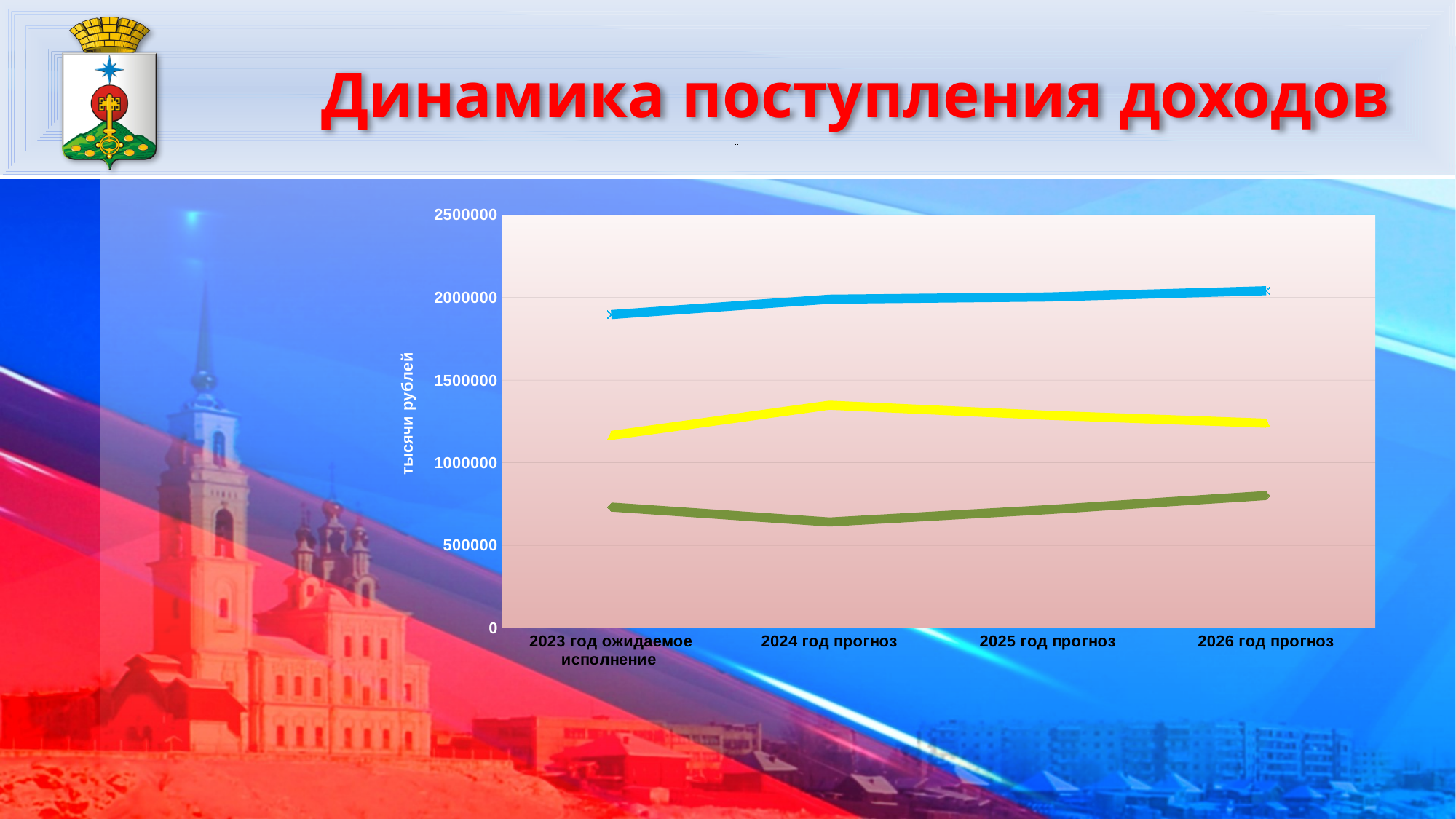
What is the title of the slide's chart? Динамика поступления доходов In which category does the yellow line reach its highest value? 2024 год прогноз Does the blue line rise or fall from 2023 год ожидаемое исполнение to 2026 год прогноз? rise Which is larger for 2023 год ожидаемое исполнение: the blue line or the yellow line? the blue line Is the value of the yellow line for 2023 год ожидаемое исполнение greater or less than 1000000? greater How many categories are shown on the x axis of the chart? 4 What kind of chart is shown on the slide? line chart Is the value of the yellow line for 2024 год прогноз greater or less than 1500000? less In which category does the green line reach its lowest value? 2024 год прогноз Is the value of the blue line for 2023 год ожидаемое исполнение greater or less than 2000000? less What is the label of the vertical axis of the chart? тысячи рублей